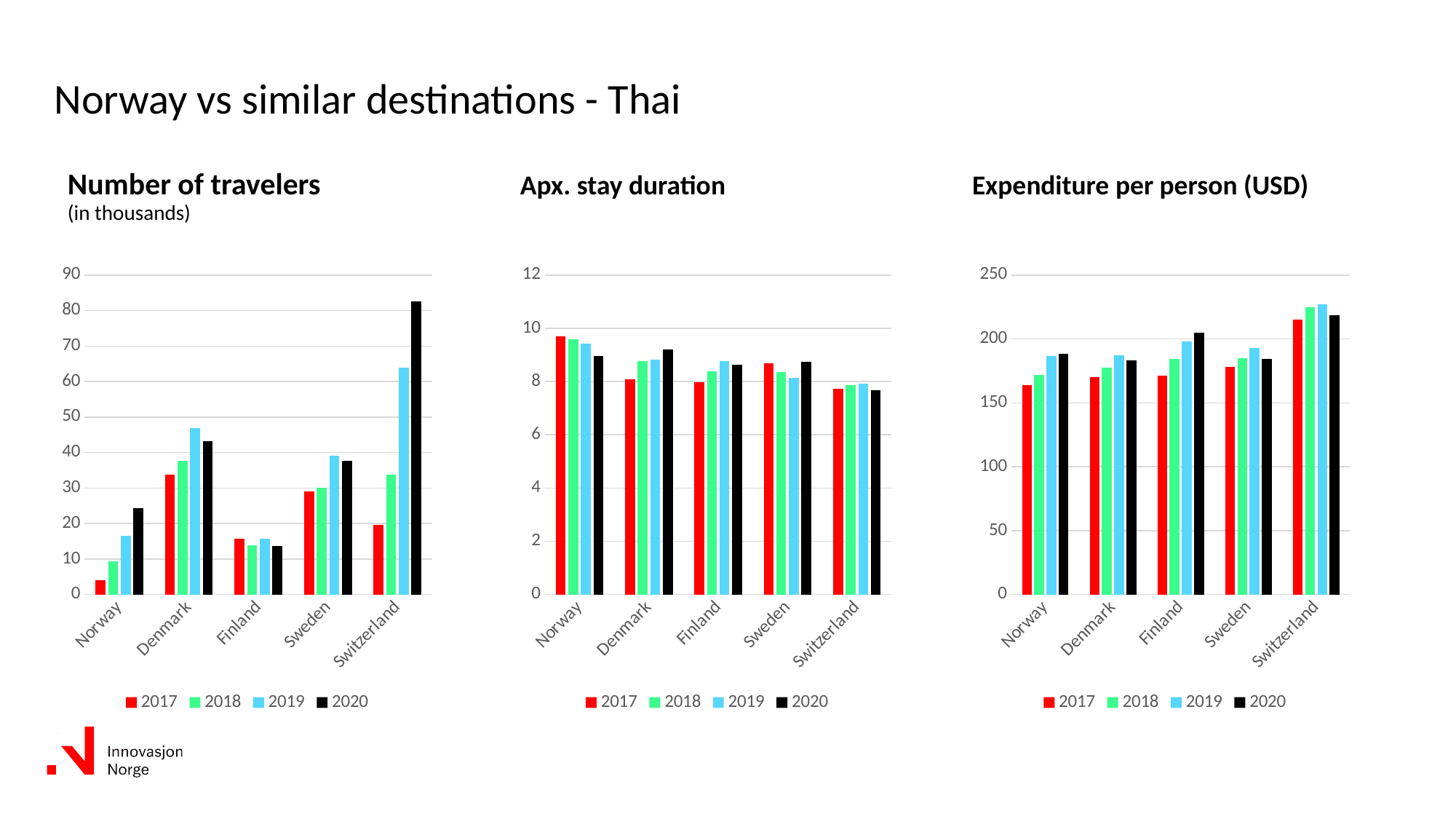
In the 'Expenditure per person (USD)' chart, is the 2017 value for Switzerland greater or less than 200? greater In the 'Number of travelers' chart, which country and year has the highest value? Switzerland, 2020 In the 'Apx. stay duration' chart, which country has the highest 2017 value? Norway In the 'Number of travelers' chart, which country has the lowest 2017 value? Norway How many series does the legend of the 'Apx. stay duration' chart list? 4 In the 'Number of travelers' chart, which is larger for 2019: Denmark or Sweden? Denmark In the 'Expenditure per person (USD)' chart, which country has the highest values? Switzerland How many countries are shown on the x axis of the 'Expenditure per person (USD)' chart? 5 In the 'Number of travelers' chart, do Norway's values rise or fall from 2017 to 2020? rise In the 'Apx. stay duration' chart, is the 2020 value for Switzerland greater or less than 8? less In the 'Number of travelers' chart, is the 2018 value for Finland greater or less than 20? less